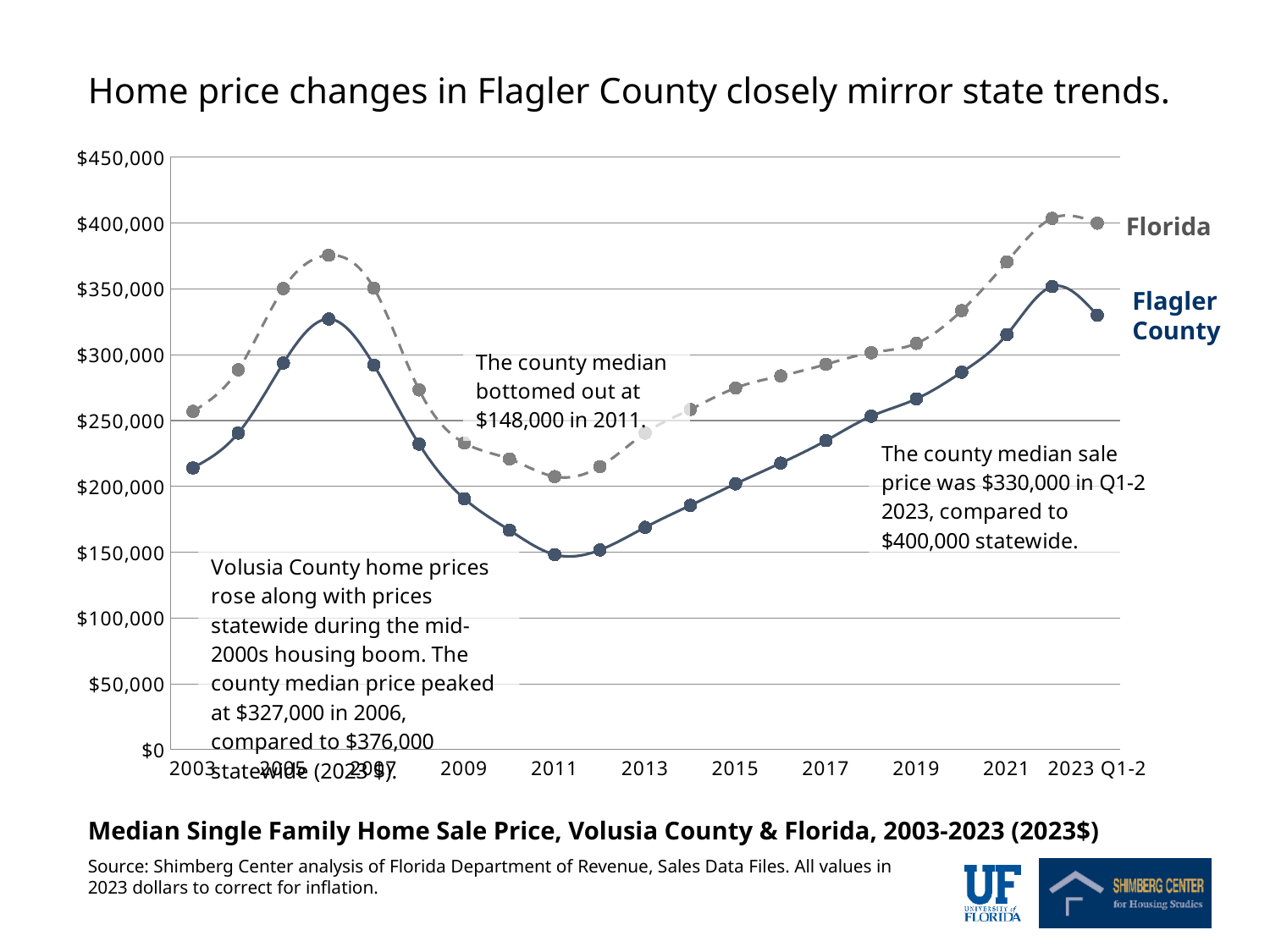
In 2011, which series had the higher median sale price, Florida or Flagler County? Florida What was the county median sale price in Q1-2 2023? $330,000 At what value did the county median price peak in 2006? $327,000 Does the Flagler County series rise or fall between 2011 and 2022? rise How many series are plotted on the chart? 2 What was the statewide (Florida) median sale price in Q1-2 2023? $400,000 What is the difference between the statewide median ($376,000) and the county median ($327,000) in 2006? $49,000 How much higher was the Florida median than the county median in Q1-2 2023? $70,000 What kind of chart is shown on the slide? line chart What was the county median home sale price in 2011, according to the chart annotation? $148,000 Is the Flagler County value for 2003 greater or less than $250,000? less What was the statewide median price in 2006, according to the annotation? $376,000